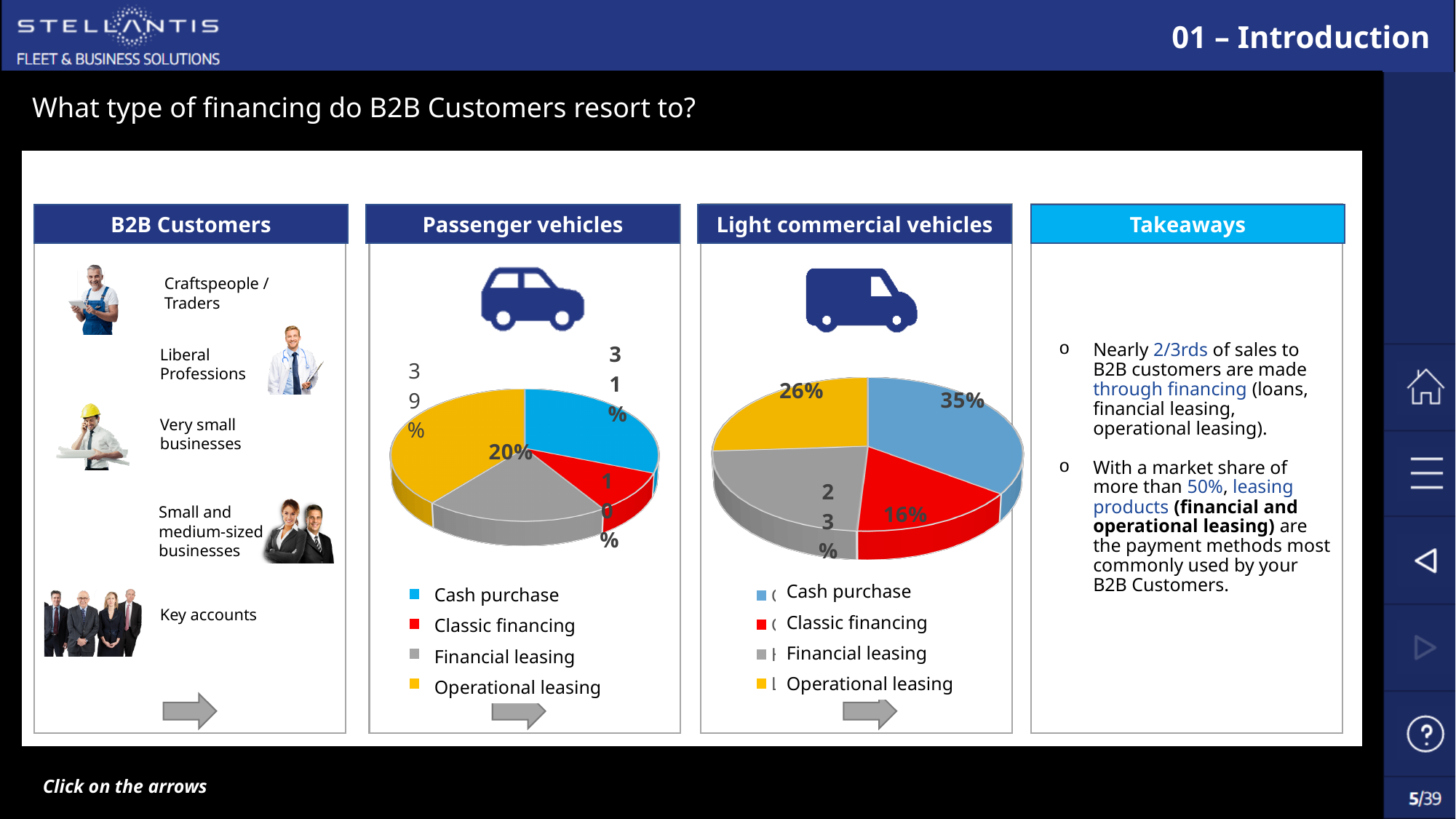
In the Passenger vehicles pie chart, what share is Financial leasing? 20% What type of chart is used in the Passenger vehicles panel? Pie chart In the Passenger vehicles pie chart, what share is Operational leasing? 39% How many slices does the Light commercial vehicles pie chart have? 4 In the Light commercial vehicles pie chart, what is the difference between Operational leasing and Financial leasing? 3% In the Light commercial vehicles pie chart, what share is Cash purchase? 35% In the Passenger vehicles pie chart, which financing type has the largest share? Operational leasing In the Passenger vehicles pie chart, which financing type has the smallest share? Classic financing In the Passenger vehicles pie chart, which colour represents Operational leasing? Yellow In the Passenger vehicles pie chart, which is larger: Cash purchase or Financial leasing? Cash purchase In the Light commercial vehicles pie chart, what share is Classic financing? 16% In the Light commercial vehicles pie chart, which financing type has the largest share? Cash purchase